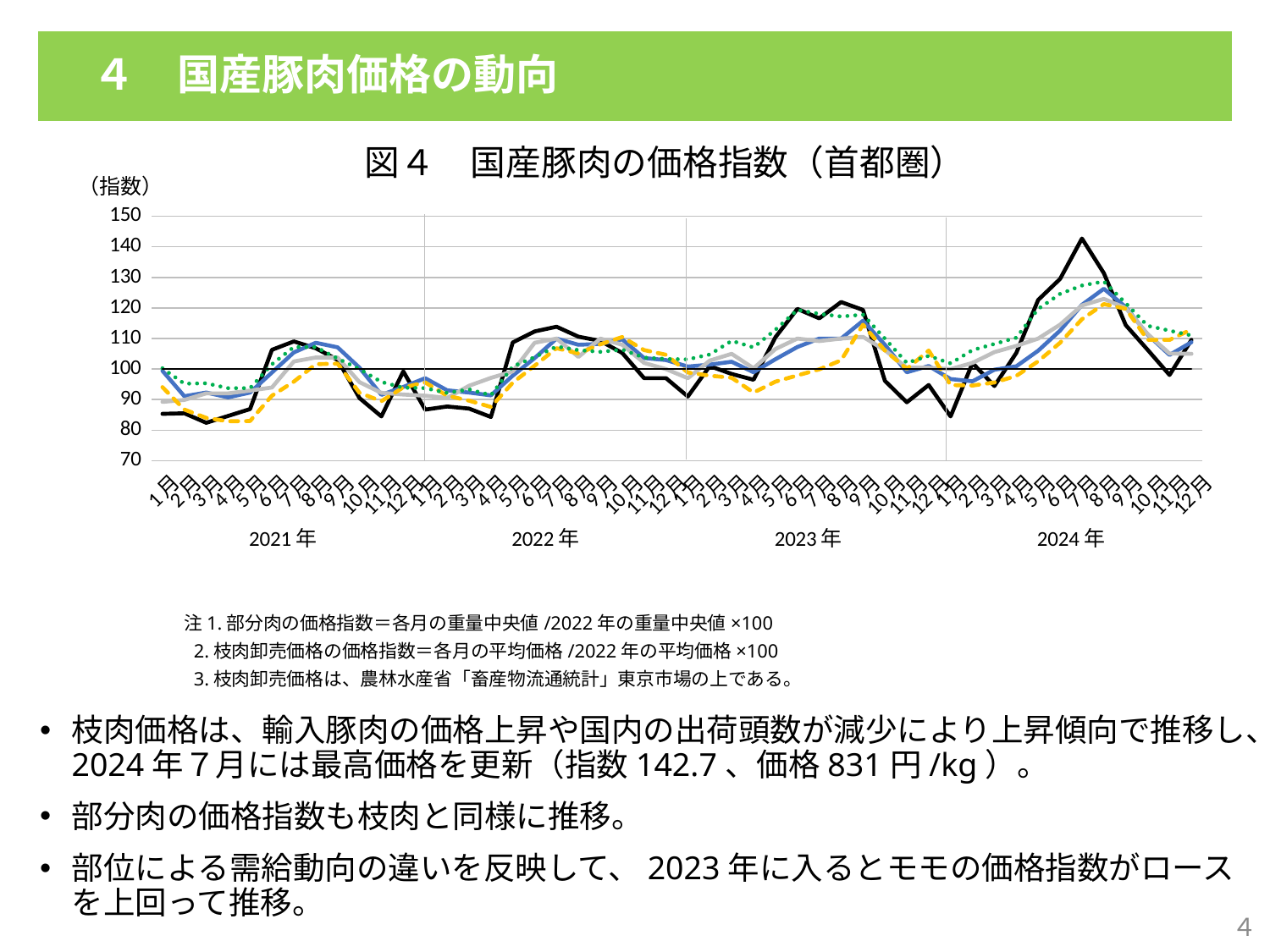
What is the highest value shown on the vertical axis of the chart? 150 In which year does the black solid line reach its highest point? 2024年 Does the black solid line rise or fall from January 2024 to July 2024? rise Is the value of the black solid line in January 2021 greater or less than 90? less How many years are labelled along the horizontal axis of the chart? 4 Is the peak of the black solid line in July 2024 greater or less than 130? greater What unit label is shown at the top of the vertical axis of the chart? （指数） What is the title of the chart on the slide? 図４ 国産豚肉の価格指数（首都圏） What kind of chart is shown in 図４ 国産豚肉の価格指数（首都圏）? line chart Is the value of the black solid line in January 2024 greater or less than 90? less Does the black solid line rise or fall from July 2024 to November 2024? fall How many lines are plotted in the chart? 6